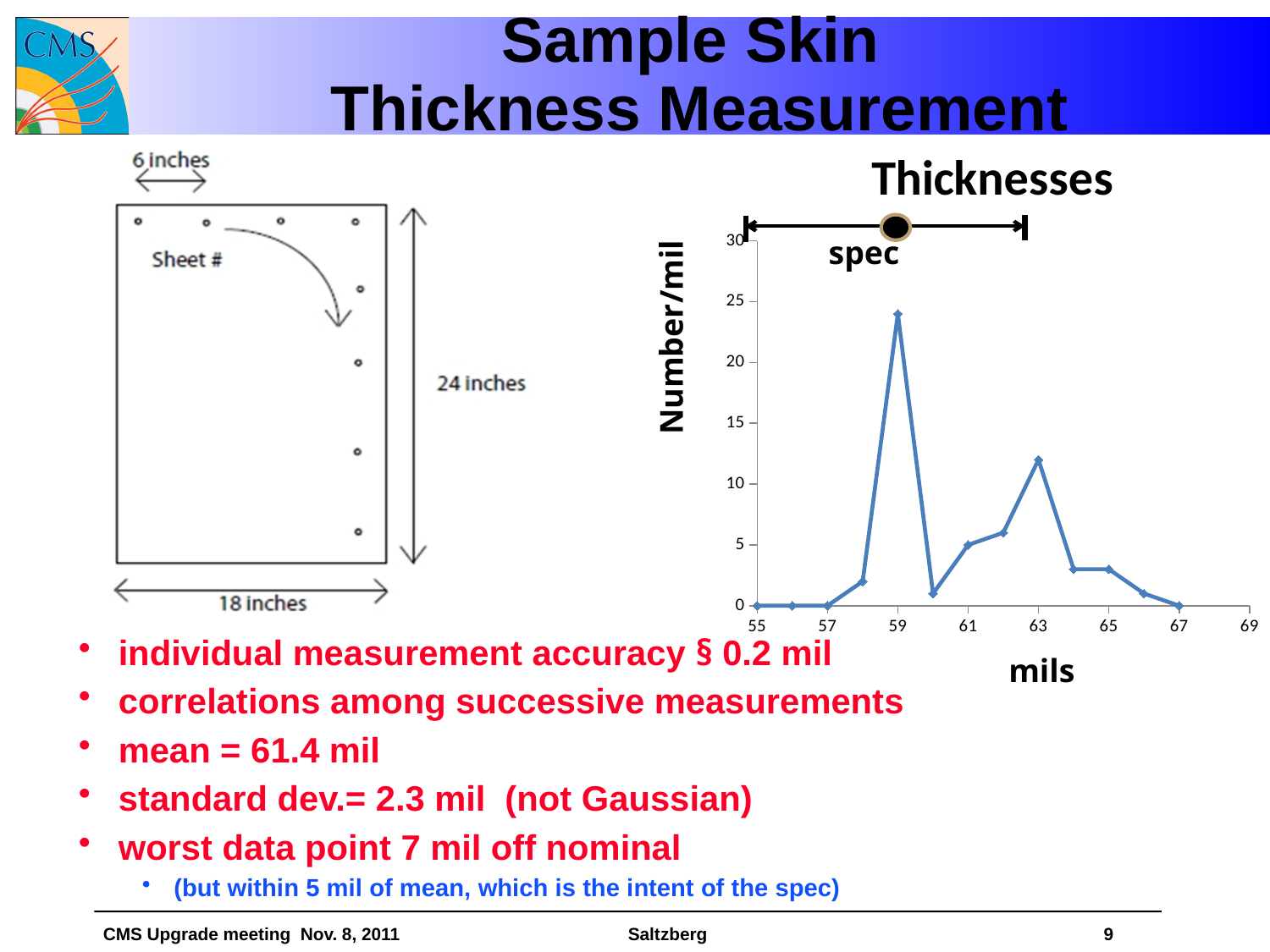
Is the value at 61 mils in the Thicknesses chart greater or less than 10? less Is the value at 58 mils in the Thicknesses chart greater or less than 5? less In the Thicknesses chart, which has the larger value: 62 mils or 64 mils? 62 mils At which x-axis value (in mils) does the Thicknesses chart reach its highest point? 59 In the Thicknesses chart, do the values rise or fall from 60 mils to 63 mils? rise What kind of chart is the Thicknesses chart? line chart Is the value at 59 mils in the Thicknesses chart greater or less than 20? greater In the Thicknesses chart, which has the larger value: 59 mils or 63 mils? 59 mils What is the label on the y axis of the Thicknesses chart? Number/mil What is the label on the x axis of the Thicknesses chart? mils